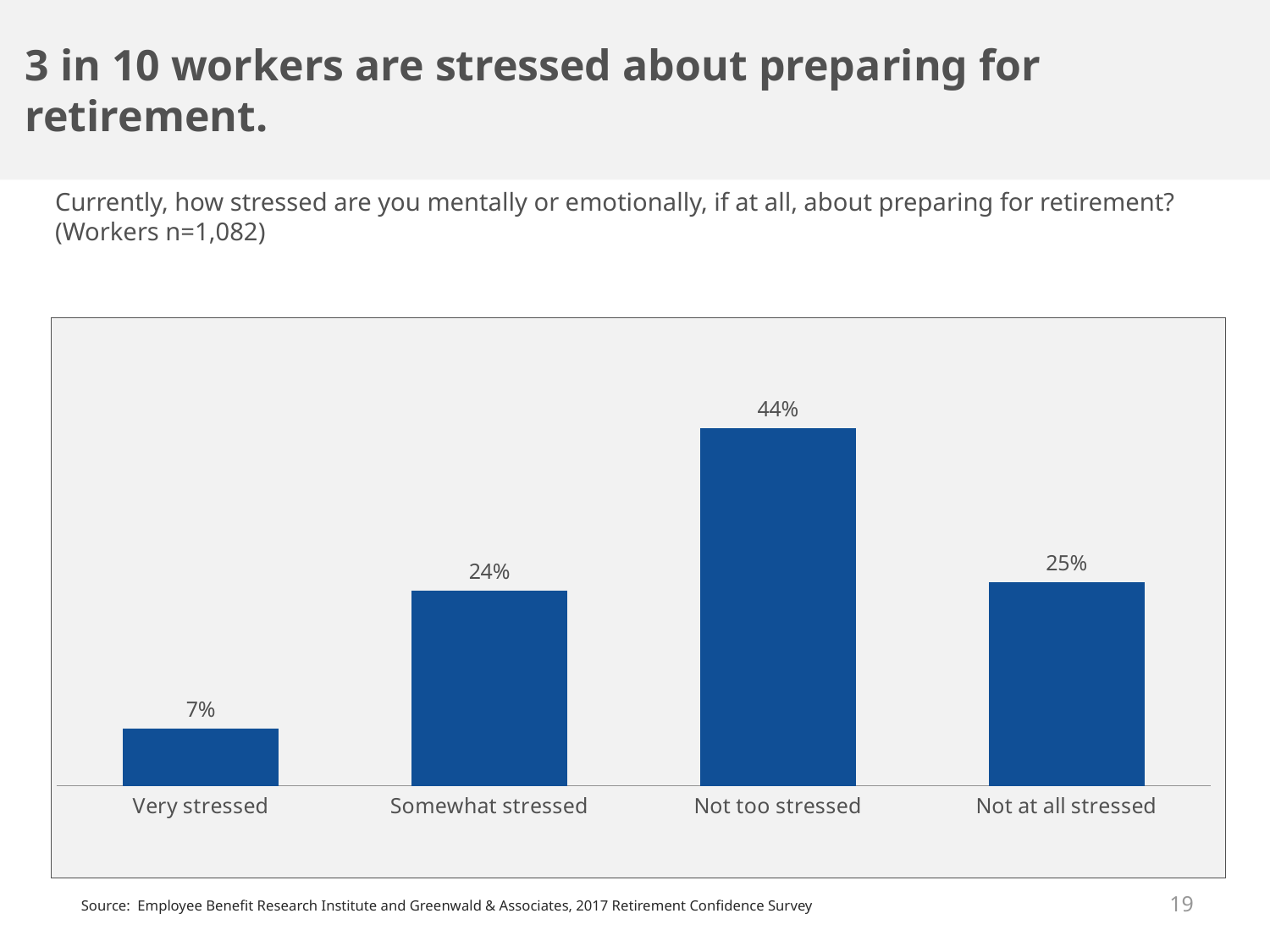
What percentage of workers say they are not too stressed about preparing for retirement? 44% What percentage of workers say they are not at all stressed about preparing for retirement? 25% What is the difference in percentage points between 'Not at all stressed' and 'Very stressed'? 18 What is the difference in percentage points between 'Not too stressed' and 'Somewhat stressed'? 20 What percentage of workers say they are very stressed about preparing for retirement? 7% How many response categories are shown in the chart? 4 What is the sample size of workers shown for the survey question? n=1,082 Which response category has the highest percentage? Not too stressed What kind of chart is shown on the slide? Bar chart Which is larger, the percentage for 'Not at all stressed' or for 'Somewhat stressed'? Not at all stressed What percentage of workers say they are somewhat stressed about preparing for retirement? 24% Which response category has the lowest percentage? Very stressed